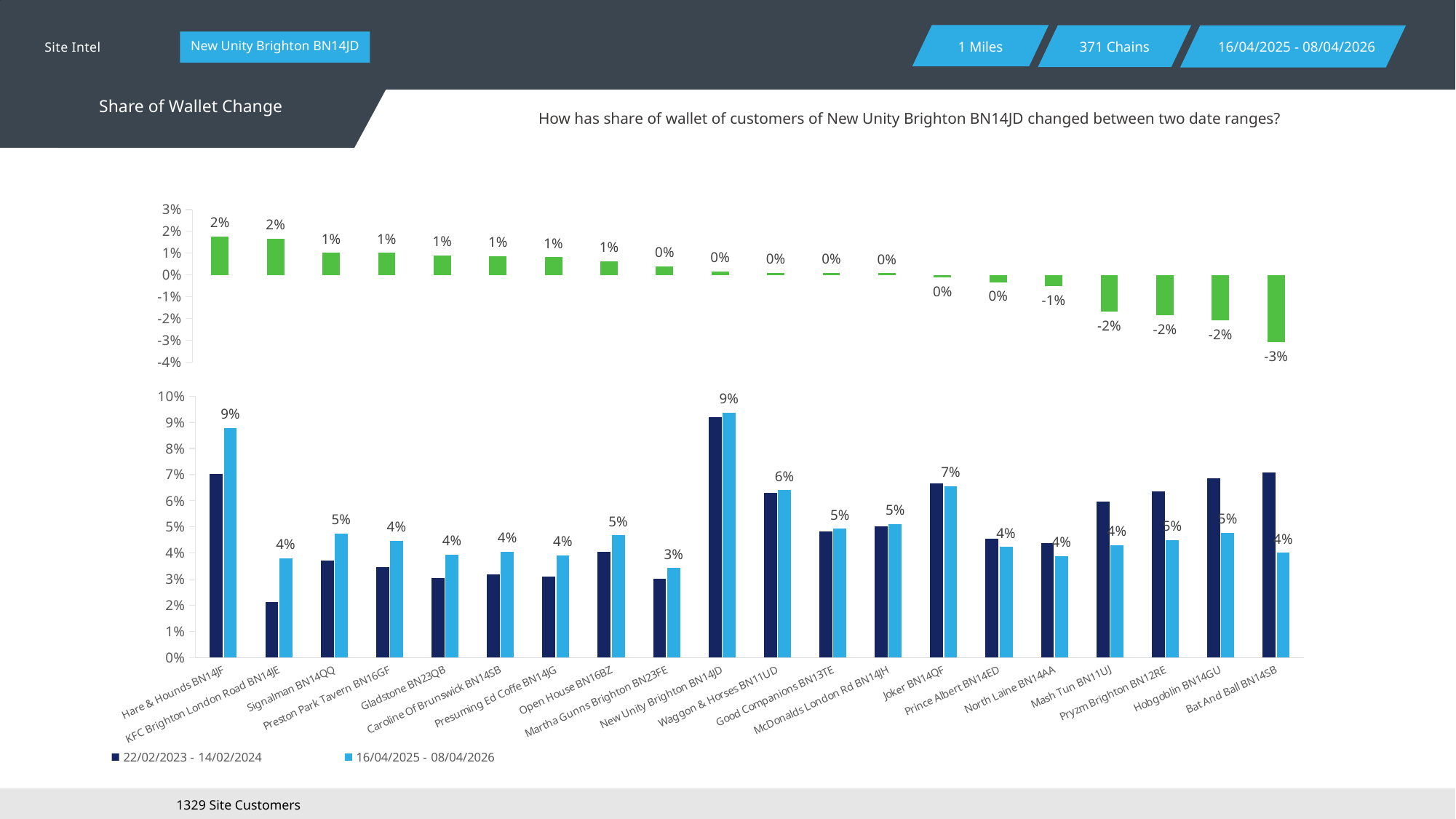
In the bottom chart, what is the difference between the 16/04/2025 - 08/04/2026 values for Hare & Hounds BN14JF and Martha Gunns Brighton BN23FE? 6% In the top chart (Share of Wallet Change), what is the value for Bat And Ball BN14SB? -3% How many series does the legend of the bottom chart list? 2 How many categories are shown in the top chart (Share of Wallet Change)? 20 In the bottom chart, is the 22/02/2023 - 14/02/2024 value for Bat And Ball BN14SB greater or less than 6%? greater In the top chart (Share of Wallet Change), what is the value for Hare & Hounds BN14JF? 2% In the bottom chart, for Hare & Hounds BN14JF, which series has the larger value: 22/02/2023 - 14/02/2024 or 16/04/2025 - 08/04/2026? 16/04/2025 - 08/04/2026 In the top chart (Share of Wallet Change), which category has the lowest value? Bat And Ball BN14SB What are the two legend entries of the bottom chart? 22/02/2023 - 14/02/2024 and 16/04/2025 - 08/04/2026 In the bottom chart, is the 22/02/2023 - 14/02/2024 value for KFC Brighton London Road BN14JE greater or less than 3%? less What kind of chart is the top chart (Share of Wallet Change)? Bar chart In the bottom chart, what is the 16/04/2025 - 08/04/2026 value for Joker BN14QF? 7%